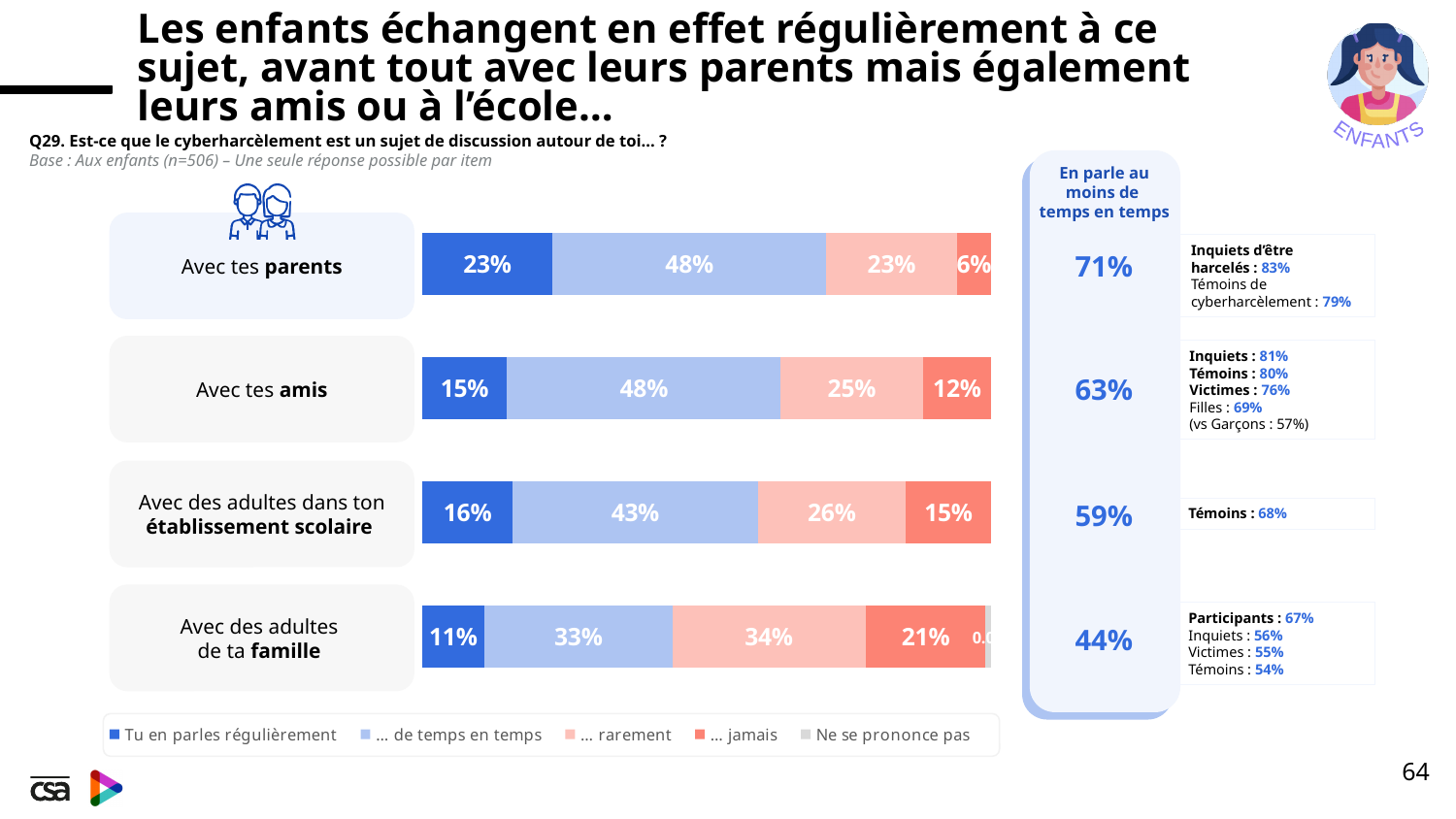
What is the "... de temps en temps" value for "Avec des adultes dans ton établissement scolaire"? 43% What type of chart is used on this slide? Stacked bar chart Which category has the highest "Tu en parles régulièrement" value? Avec tes parents How many series does the chart legend list? 5 Which category has the lowest "... de temps en temps" value? Avec des adultes de ta famille What is the "... jamais" value for "Avec des adultes de ta famille"? 21% Which is larger: the "... rarement" value for "Avec tes amis" or for "Avec des adultes de ta famille"? Avec des adultes de ta famille What is the combined share of "Tu en parles régulièrement" and "... de temps en temps" for "Avec des adultes dans ton établissement scolaire"? 59% What percentage of children say they talk regularly ("Tu en parles régulièrement") about cyberbullying with their parents ("Avec tes parents")? 23% How many categories (rows) are shown in the stacked bar chart? 4 According to the "En parle au moins de temps en temps" column, what is the value for "Avec tes amis"? 63% What is the difference between the "... jamais" values for "Avec tes amis" and "Avec tes parents"? 6%